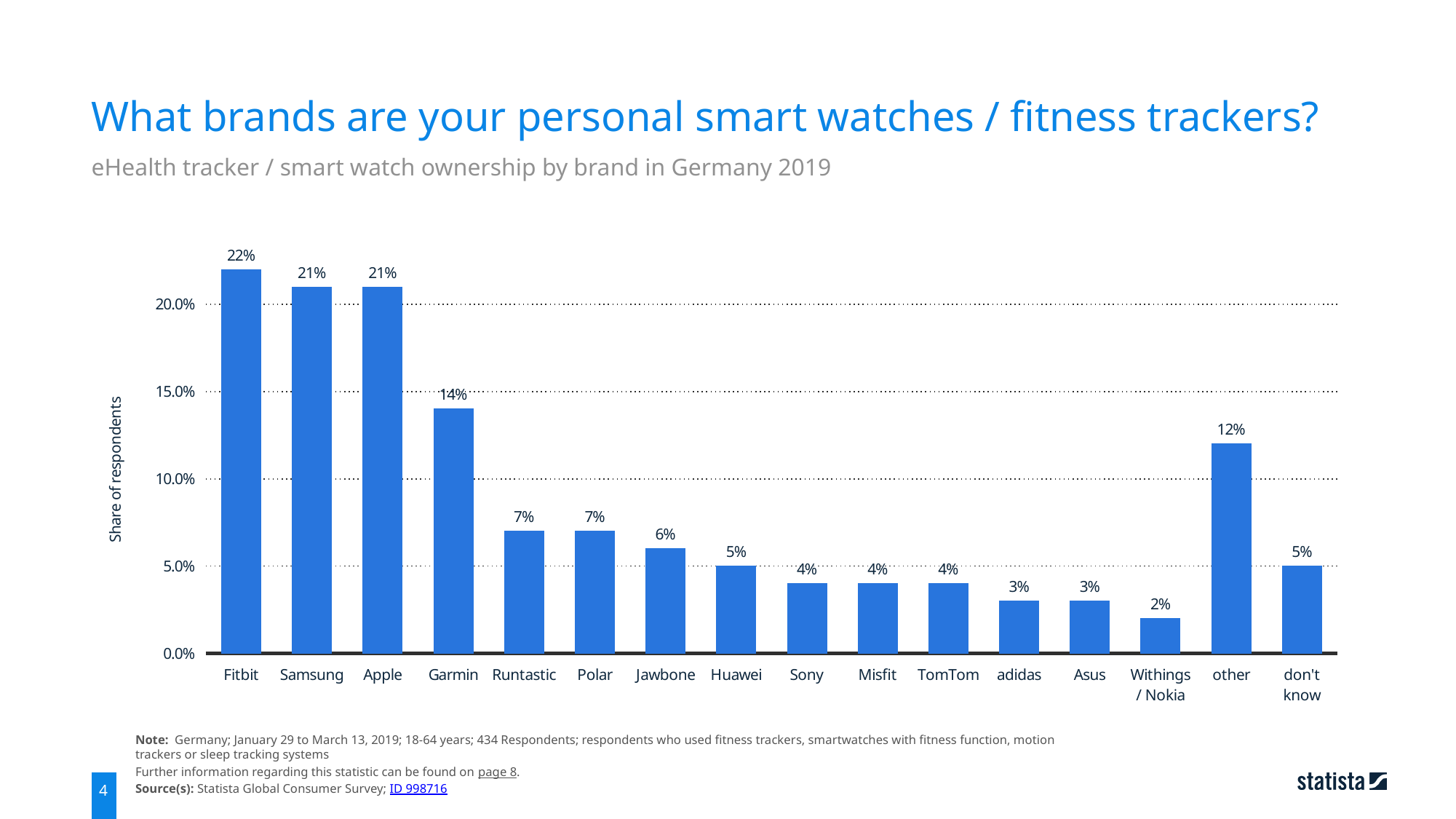
Which has a larger share of respondents, Jawbone or Huawei? Jawbone Is the value for Apple greater or less than 20.0%? greater Which brand has the highest share of respondents? Fitbit What kind of chart is shown on the slide? Bar chart Which category has the lowest share of respondents? Withings / Nokia What share of respondents answered 'other'? 12% What share of respondents own a Fitbit smart watch or fitness tracker? 22% How many categories are shown on the x axis? 16 What is the value shown for 'don't know'? 5% What is the difference between the shares for Fitbit and Garmin? 8% What is the value shown for Garmin? 14% What is the label of the y axis? Share of respondents